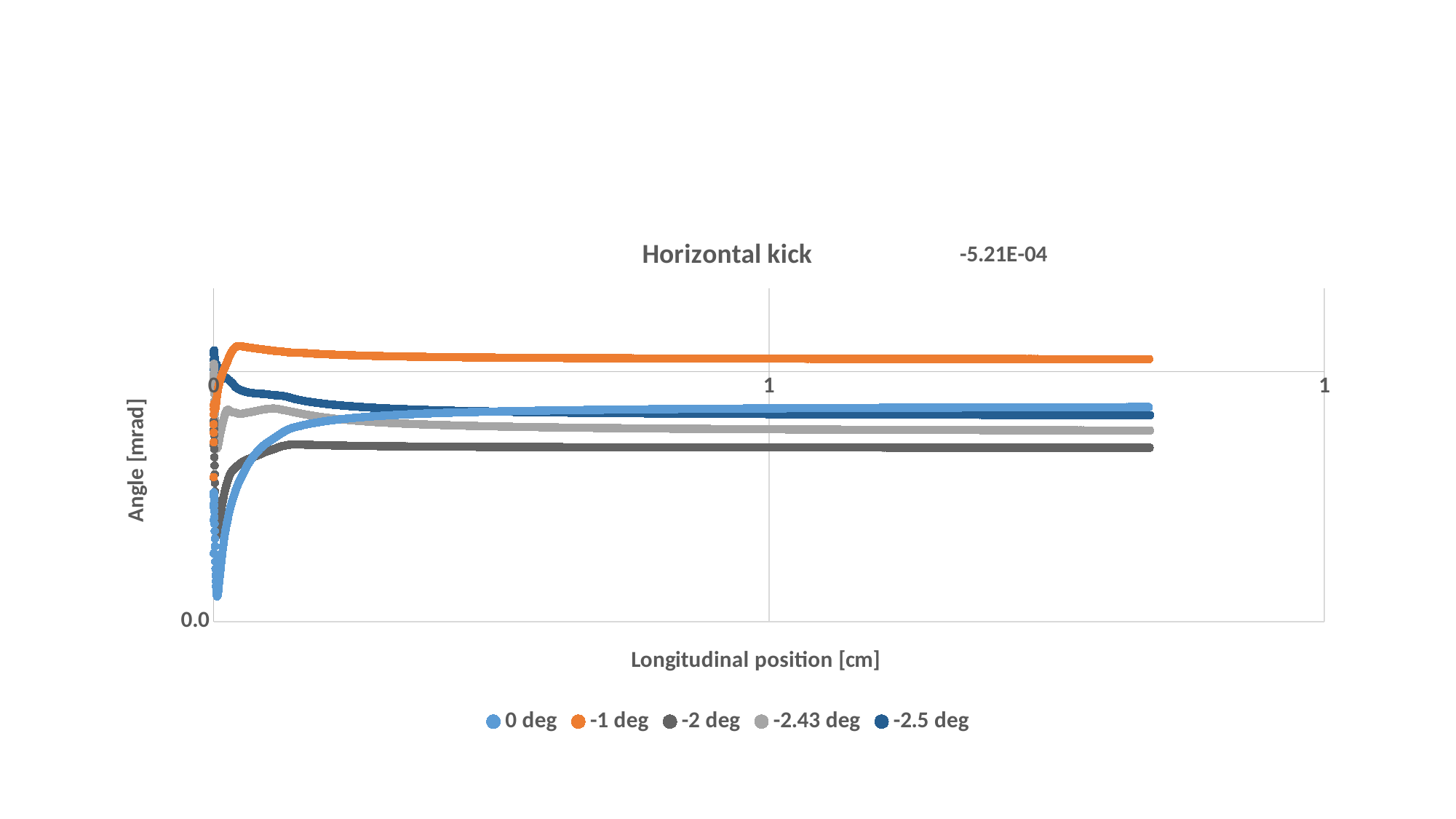
What is the label of the vertical axis? Angle [mrad] Which series is plotted in orange? -1 deg What is the title of the chart? Horizontal kick Which series has the lowest angle at the right end of the plotted curves? -2 deg What kind of chart is shown on the slide? Scatter (line) chart Does the -2.5 deg series rise or fall along the x axis after its initial peak near the start? Fall Does the 0 deg series rise or fall along the x axis after its initial dip near the start? Rise Which series has the highest angle at the right end of the plotted curves? -1 deg At the right end of the curves, which series is higher: -1 deg or 0 deg? -1 deg How many series does the legend of the Horizontal kick chart list? 5 At the right end of the curves, which series is higher: -2 deg or -2.43 deg? -2.43 deg